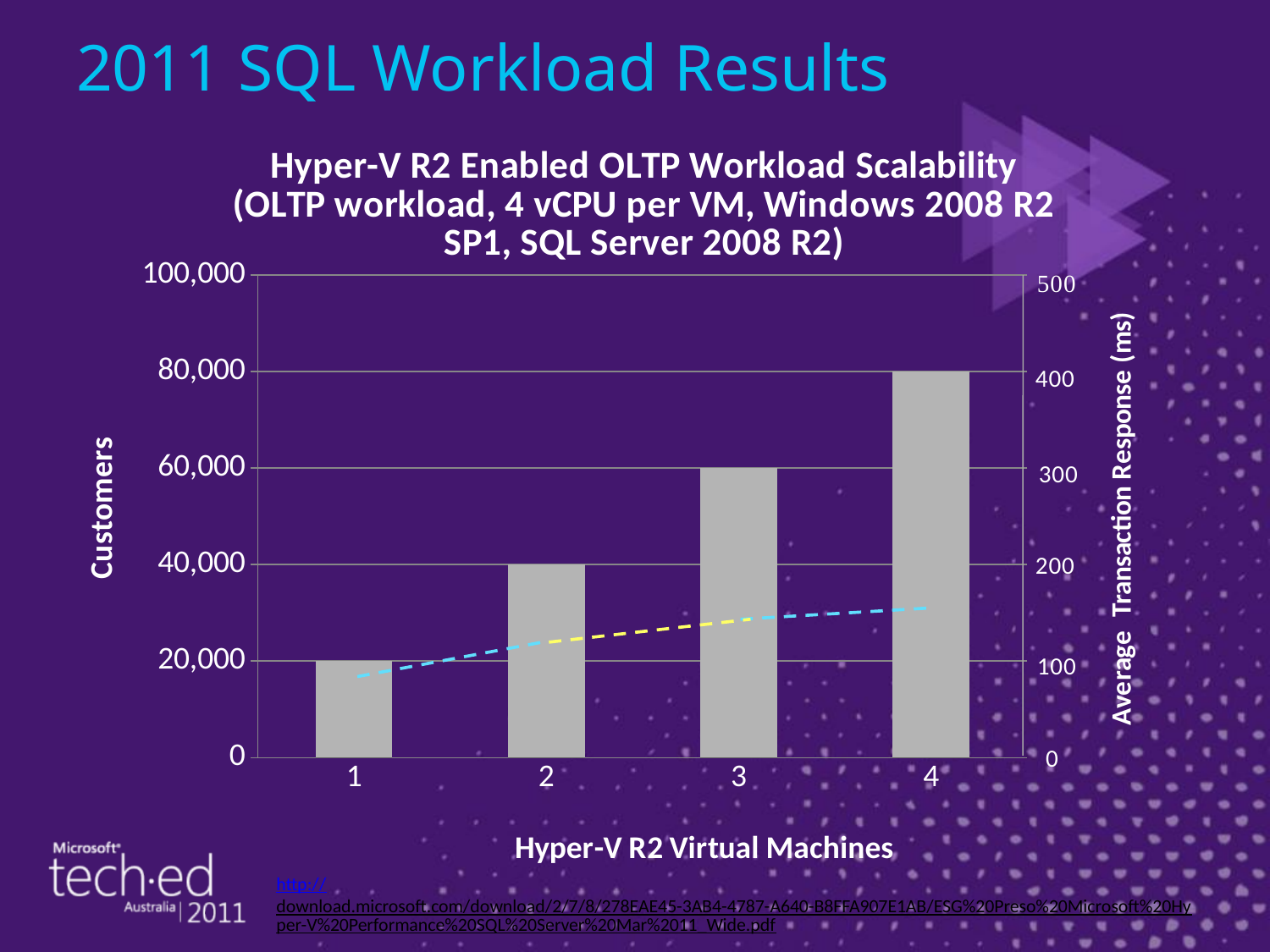
What is the Customers value for 2 Hyper-V R2 Virtual Machines? 40,000 Which number of Hyper-V R2 Virtual Machines has the highest Customers value? 4 What is the difference in Customers between 3 and 1 Hyper-V R2 Virtual Machines? 40,000 Which number of Hyper-V R2 Virtual Machines has the lowest Customers value? 1 How many Hyper-V R2 Virtual Machines categories are shown on the x axis? 4 Is the Average Transaction Response (ms) for 4 Hyper-V R2 Virtual Machines greater or less than 200? less Do the Customers values rise or fall as the number of Hyper-V R2 Virtual Machines increases? rise What is the Customers value for 1 Hyper-V R2 Virtual Machine? 20,000 What is the label of the left vertical axis? Customers What type of chart is shown on the slide? bar chart Which has more Customers, 2 or 3 Hyper-V R2 Virtual Machines? 3 What is the Customers value for 4 Hyper-V R2 Virtual Machines? 80,000